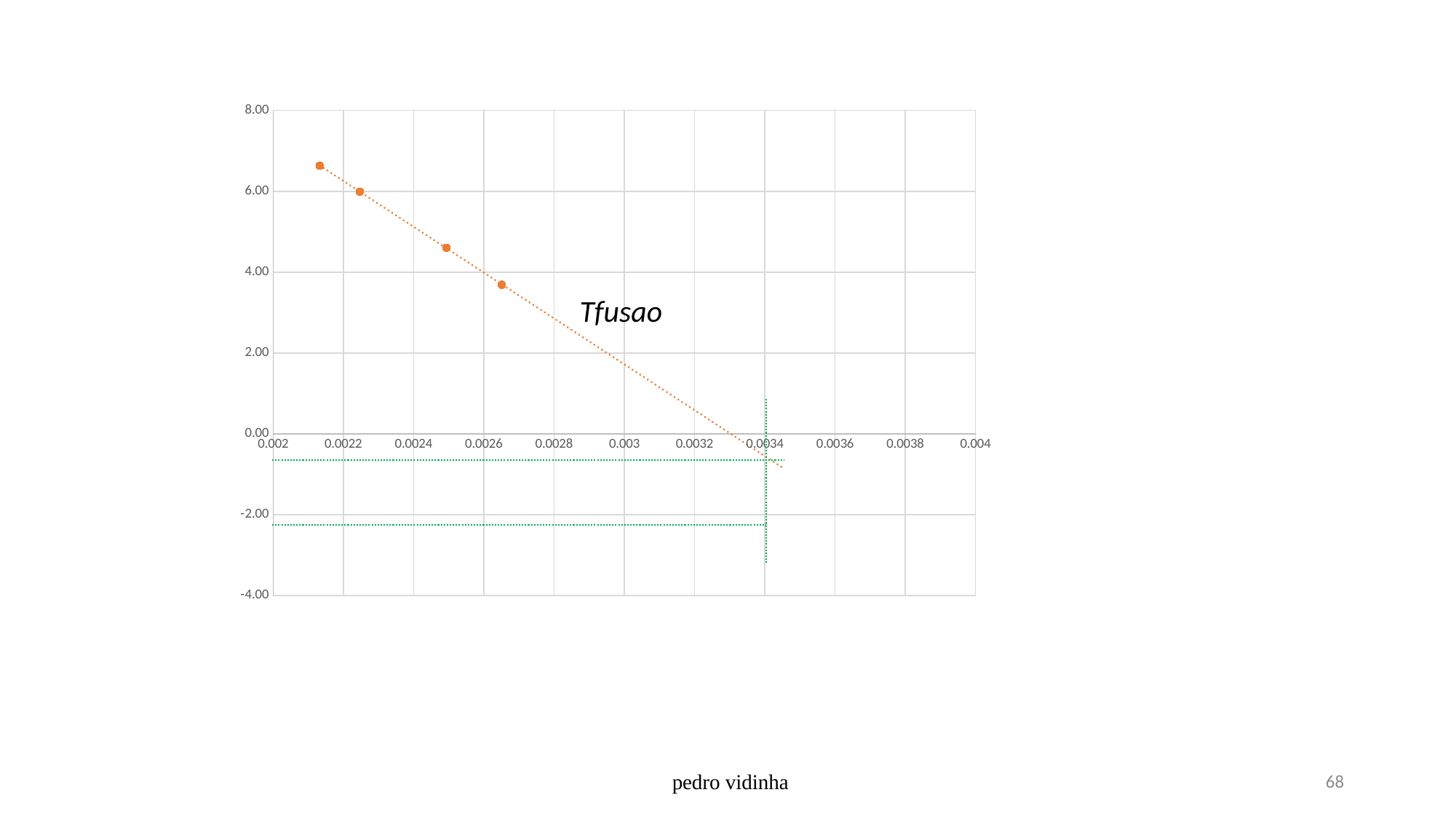
What text label is written next to the trendline on the chart? Tfusao Is the value of the rightmost data point greater or less than 2.00? greater Is the value of the leftmost data point greater or less than 6.00? greater Do the plotted values rise or fall as the x value increases? fall What is the highest value shown on the y axis? 8.00 Is the value of the third data point from the left greater or less than 4.00? greater What kind of chart is shown on the slide? scatter chart How many data points are plotted on the chart? 4 Which data point has the higher value, the leftmost or the rightmost? the leftmost